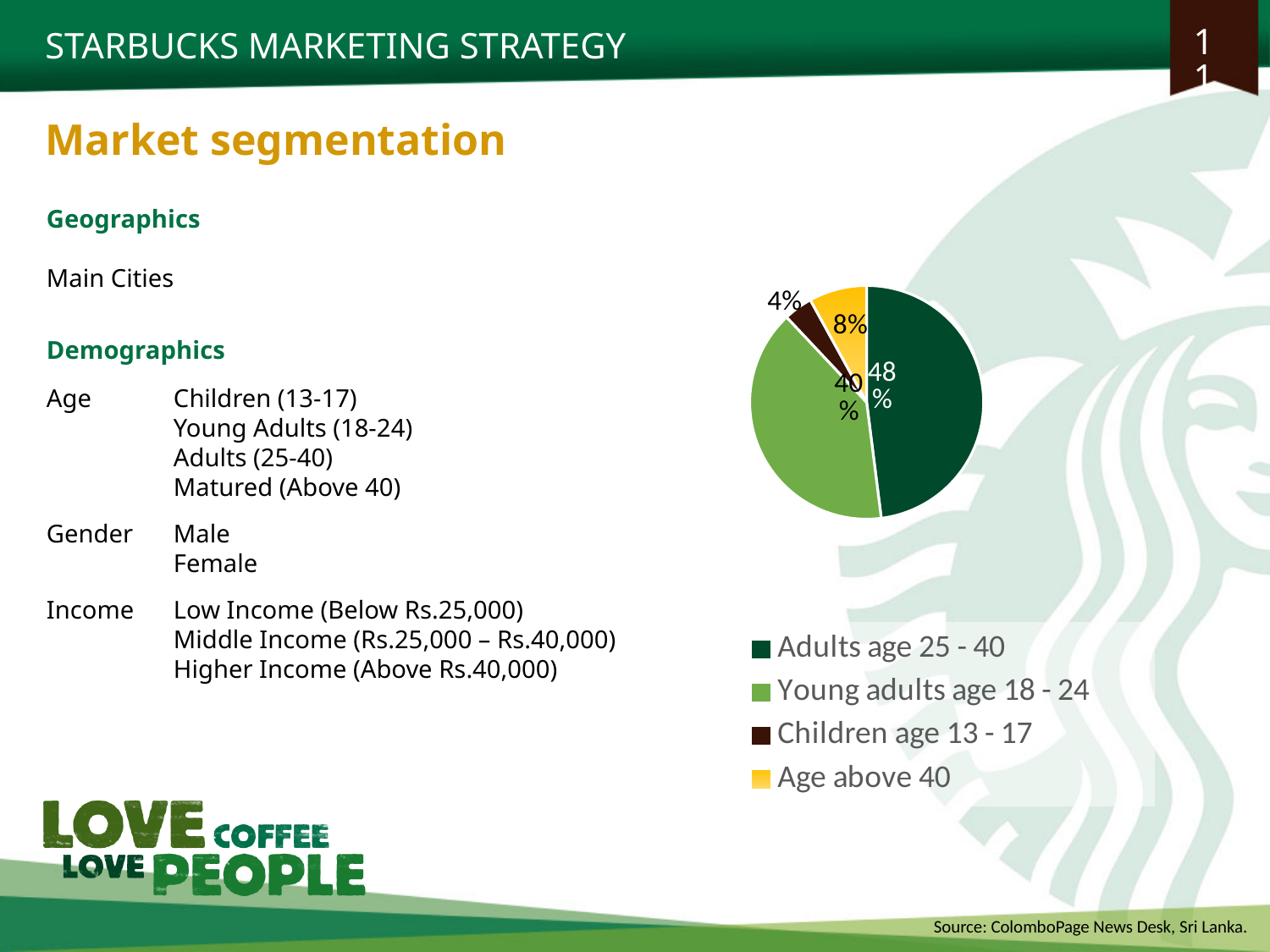
What share of the pie chart is Age above 40? 8% Which segment has the largest share of the pie chart? Adults age 25 - 40 What share of the pie chart is Children age 13 - 17? 4% What share of the pie chart is Young adults age 18 - 24? 40% What colour represents Age above 40 in the pie chart? Yellow What is the difference in percentage points between Adults age 25 - 40 and Young adults age 18 - 24? 8 How many segments does the pie chart have? 4 Which is larger in the pie chart: Age above 40 or Children age 13 - 17? Age above 40 How many entries does the legend of the pie chart list? 4 What type of chart is shown on the slide? Pie chart What share of the pie chart is Adults age 25 - 40? 48% Which segment has the smallest share of the pie chart? Children age 13 - 17